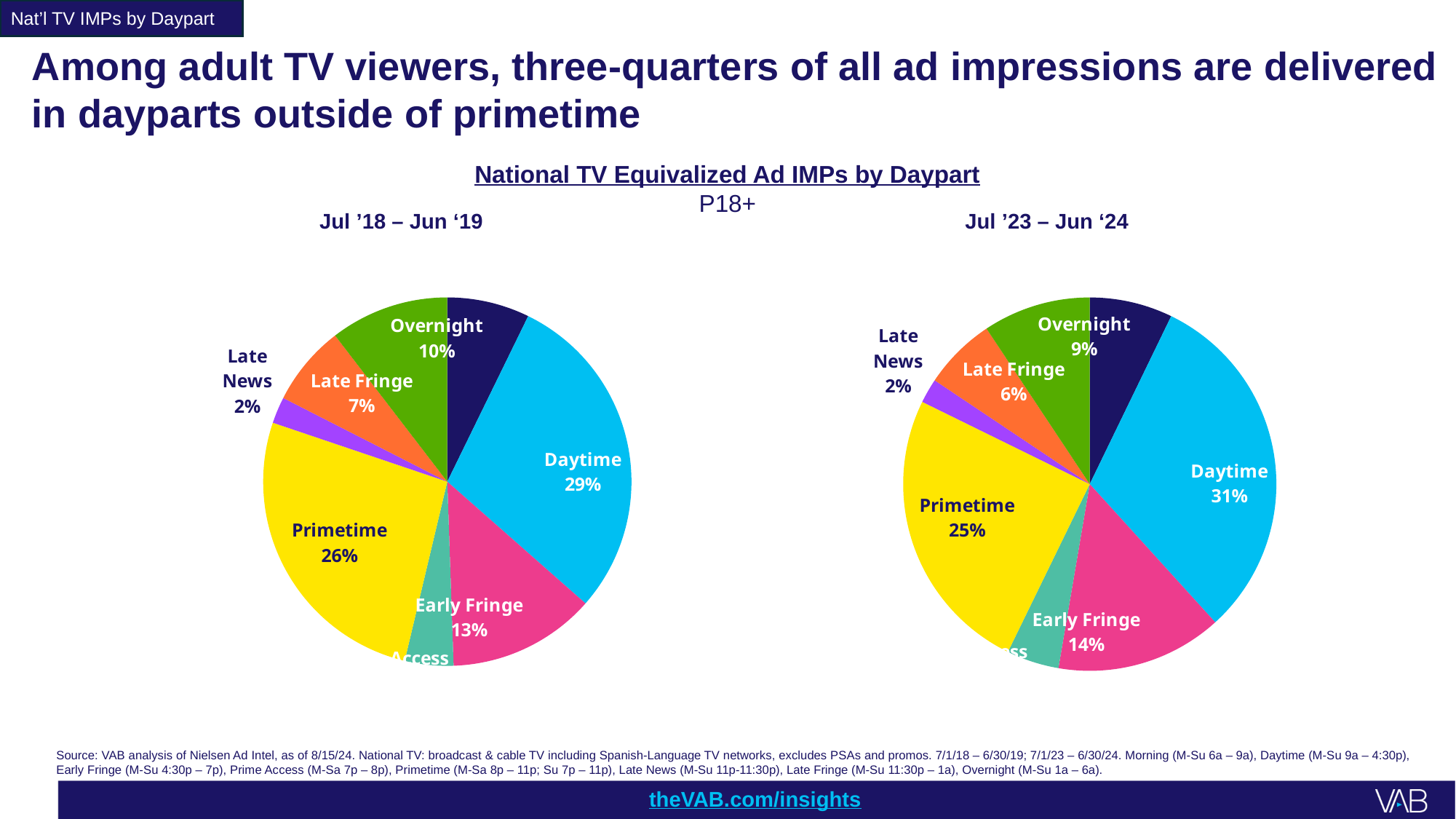
In the Jul '23 – Jun '24 pie chart, what is the value for Overnight? 9% What is the title shown above the two pie charts? National TV Equivalized Ad IMPs by Daypart How many slices does each pie chart contain? 8 In the Jul '18 – Jun '19 pie chart, what share of ad impressions does Daytime account for? 29% In the Jul '23 – Jun '24 pie chart, what share of ad impressions does Primetime account for? 25% In the Jul '23 – Jun '24 pie chart, which daypart has the largest share? Daytime In the Jul '18 – Jun '19 pie chart, what is the value for Late Fringe? 7% In the Jul '23 – Jun '24 pie chart, what is the value for Early Fringe? 14% In the Jul '18 – Jun '19 pie chart, which daypart has the largest share? Daytime In the Jul '23 – Jun '24 pie chart, which is larger, Daytime or Primetime? Daytime How many percentage points higher is Daytime's share in the Jul '23 – Jun '24 chart than in the Jul '18 – Jun '19 chart? 2 percentage points What type of charts are shown on the slide? Pie charts